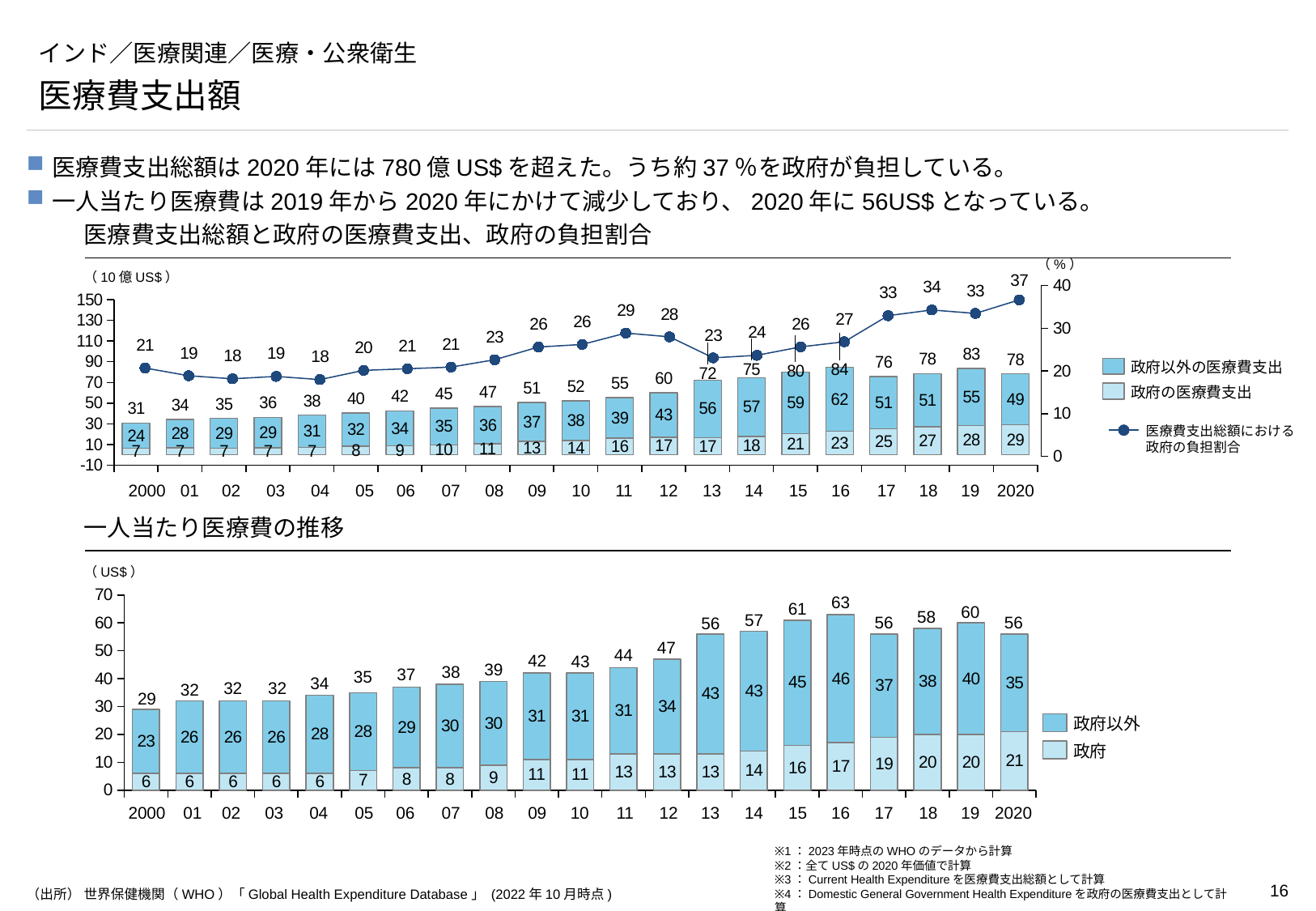
In the top chart (医療費支出総額と政府の医療費支出、政府の負担割合), what is the 政府の負担割合 (%) for 2017? 33 In the top chart (医療費支出総額と政府の医療費支出、政府の負担割合), what is the value of 政府の医療費支出 for 2020? 29 In the bottom chart (一人当たり医療費の推移), how many years are shown on the x axis? 21 In the top chart (医療費支出総額と政府の医療費支出、政府の負担割合), what is the difference between 政府以外の医療費支出 and 政府の医療費支出 in 2016? 39 What type of chart is the bottom chart (一人当たり医療費の推移)? Stacked bar chart In the top chart (医療費支出総額と政府の医療費支出、政府の負担割合), how many series does the legend list? 3 In the top chart (医療費支出総額と政府の医療費支出、政府の負担割合), which year has the highest total health expenditure? 2016 In the top chart (医療費支出総額と政府の医療費支出、政府の負担割合), which year has the lowest 政府の負担割合? 2002 and 2004 (18%) In the bottom chart (一人当たり医療費の推移), is the 政府以外 value larger in 2015 or in 2017? 2015 In the bottom chart (一人当たり医療費の推移), what is the 政府 value for 2018? 20 In the top chart (医療費支出総額と政府の医療費支出、政府の負担割合), what is the total of the stacked bar for 2013? 72 In the bottom chart (一人当たり医療費の推移), which year has the highest per-capita health expenditure? 2016